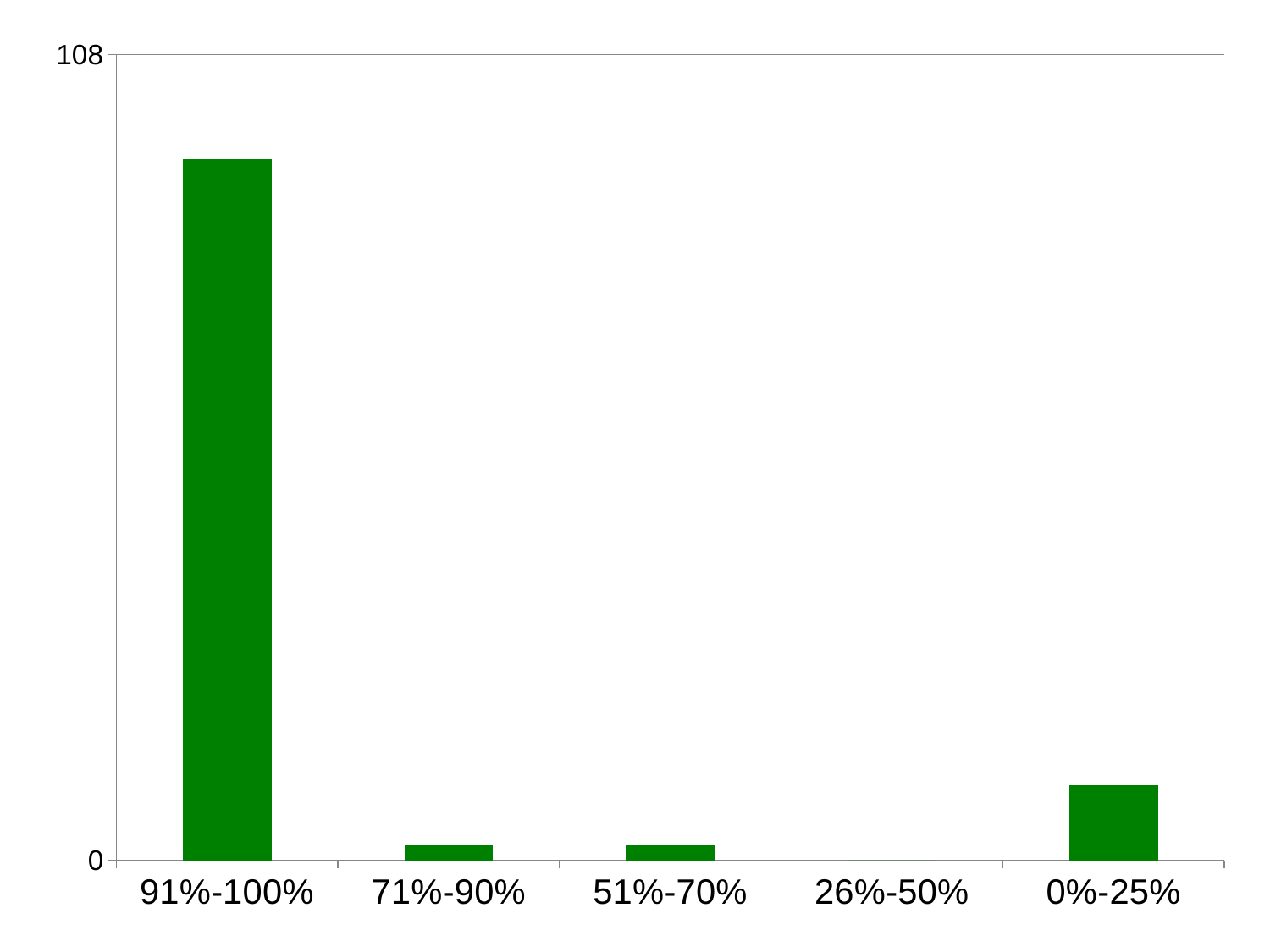
Which is larger, the value for 0%-25% or the value for 71%-90%? 0%-25% Which is larger, the value for 91%-100% or the value for 0%-25%? 91%-100% Which category has the highest value? 91%-100% What colour are the bars in the chart? green Which category has the lowest value? 26%-50% What kind of chart is shown on the slide? bar chart Which is larger, the value for 0%-25% or the value for 51%-70%? 0%-25% How many categories are shown on the x axis? 5 What is the label of the first category on the x axis? 91%-100% What is the highest value labelled on the y axis? 108